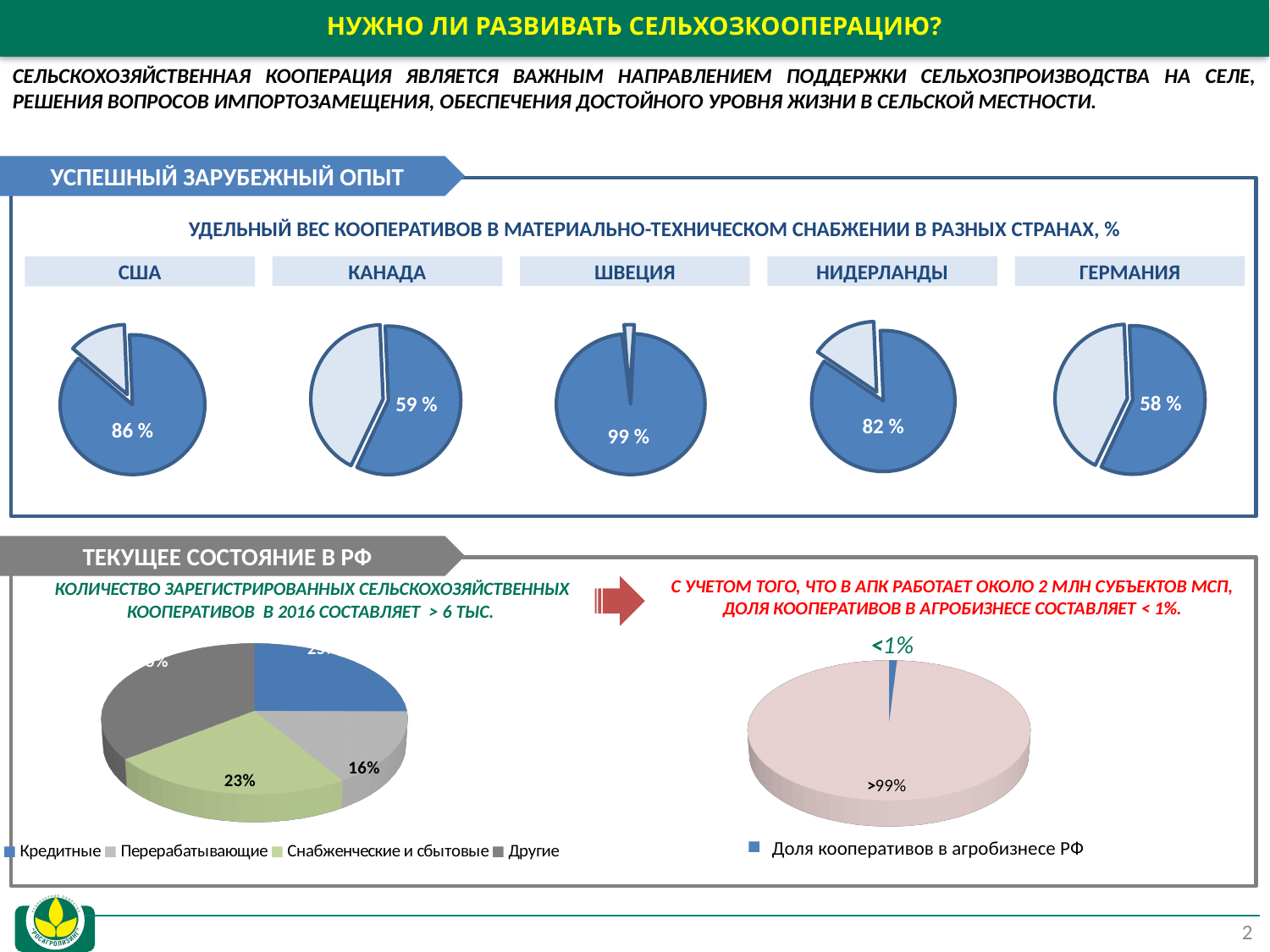
In the top section of pie charts by country, which is larger: the value for Нидерланды or the value for Германия? Нидерланды In the top section of pie charts by country, what is the difference between the values for США and Канада? 27 percentage points In the top section of pie charts by country, what is the value shown for Нидерланды? 82 % In the top section 'Удельный вес кооперативов в материально-техническом снабжении в разных странах, %', what is the value shown for США? 86 % In the top section of pie charts by country, which country has the lowest share of cooperatives? Германия In the top section of pie charts by country, which country has the highest share of cooperatives? Швеция In the bottom-left pie chart on registered agricultural cooperatives, what share is shown for Снабженческие и сбытовые? 23% How many country pie charts are shown in the top section 'Успешный зарубежный опыт'? 5 How many entries does the legend of the bottom-left pie chart list? 4 In the bottom-left pie chart on registered agricultural cooperatives, what share is shown for Перерабатывающие? 16% What type of chart is used in the bottom-right chart 'Доля кооперативов в агробизнесе РФ'? Pie chart In the top section of pie charts by country, what is the value shown for Канада? 59 %